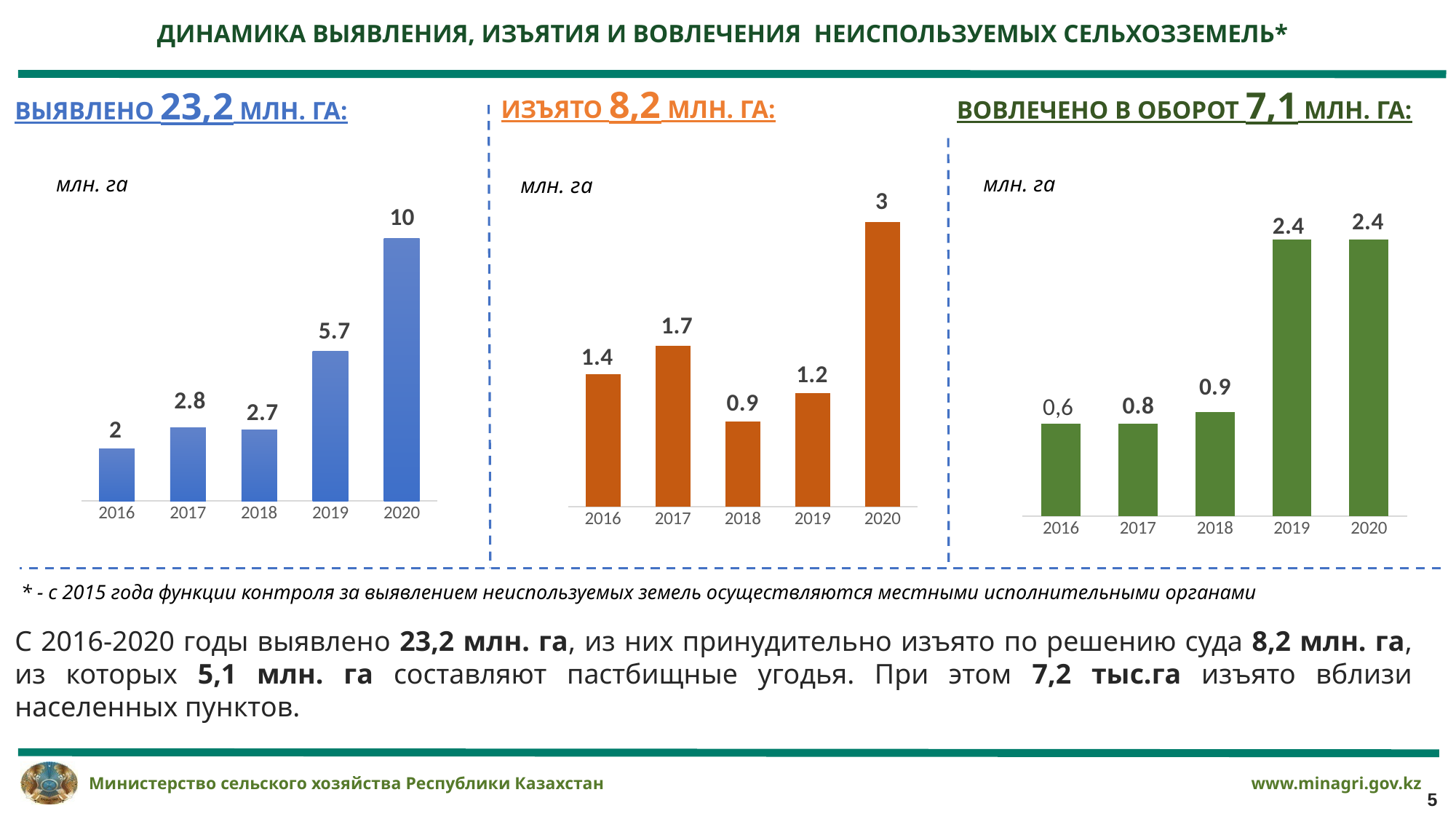
In the left chart (ВЫЯВЛЕНО), which year has the lowest value? 2016 What type of chart is the middle chart (ИЗЪЯТО)? bar chart In the right chart (ВОВЛЕЧЕНО В ОБОРОТ), which is larger, the value for 2018 or the value for 2019? 2019 In the middle chart (ИЗЪЯТО), which year has the highest value? 2020 What colour are the bars in the right chart (ВОВЛЕЧЕНО В ОБОРОТ)? green In the right chart (ВОВЛЕЧЕНО В ОБОРОТ), what is the value for 2019? 2.4 In the middle chart (ИЗЪЯТО), what is the value for 2017? 1.7 In the middle chart (ИЗЪЯТО), what is the difference between the values for 2020 and 2018? 2.1 In the right chart (ВОВЛЕЧЕНО В ОБОРОТ), what is the value for 2016? 0,6 In the left chart (ВЫЯВЛЕНО), what is the value for 2019? 5.7 In the left chart (ВЫЯВЛЕНО), what is the value for 2020? 10 How many years are shown on the x axis of the left chart (ВЫЯВЛЕНО)? 5